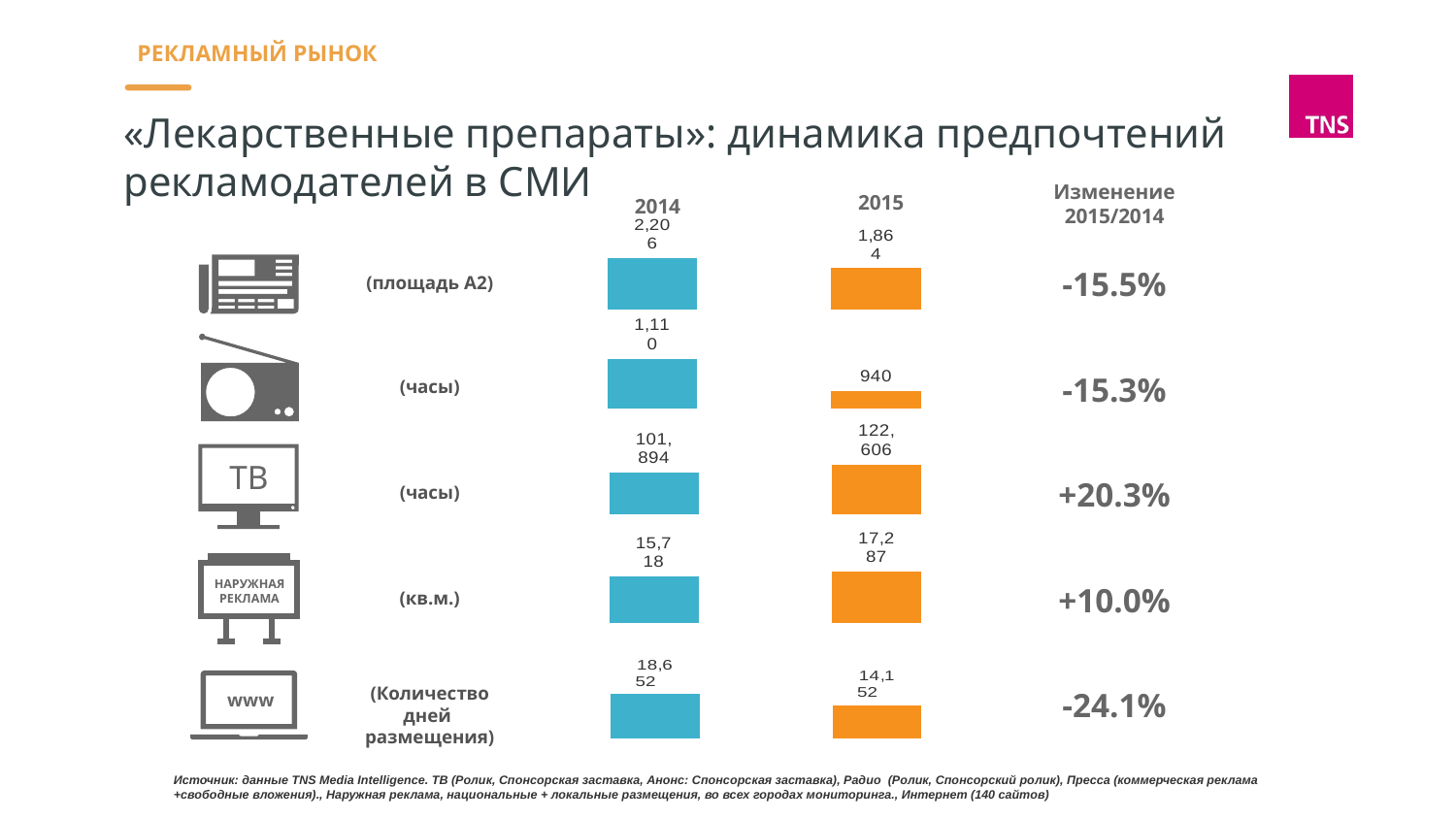
Which row shows the most negative Изменение 2015/2014? www (Количество дней размещения), -24.1% What is the 2015 value in the ТВ (часы) row? 122,606 How many media rows are compared on the slide? 5 What is the Изменение 2015/2014 shown for the www (Количество дней размещения) row? -24.1% Which row shows the largest positive Изменение 2015/2014? ТВ (часы), +20.3% By how much did the ТВ (часы) value increase from 2014 to 2015? 20,712 Which colour represents the 2015 bars? Orange What is the Изменение 2015/2014 shown for the НАРУЖНАЯ РЕКЛАМА (кв.м.) row? +10.0% What is the 2014 value in the (площадь А2) row? 2,206 What is the 2014 value in the ТВ (часы) row? 101,894 What is the 2015 value in the www (Количество дней размещения) row? 14,152 In the www (Количество дней размещения) row, which year has the larger value, 2014 or 2015? 2014